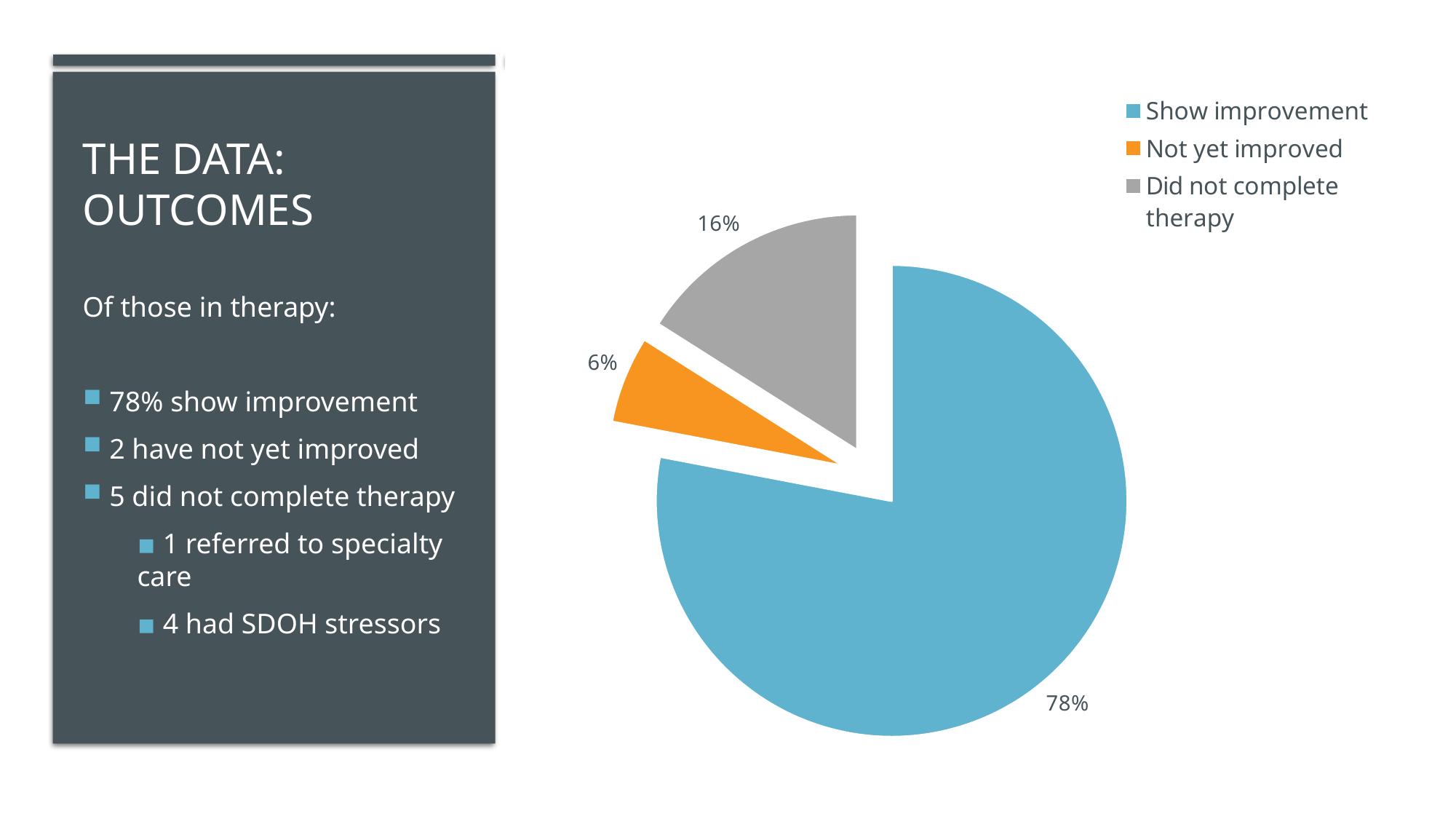
What kind of chart is shown on the slide? pie chart What share of the pie does "Show improvement" take? 78% Which slice of the pie is the largest? Show improvement Which is larger: the "Did not complete therapy" slice or the "Not yet improved" slice? Did not complete therapy How many entries does the legend list? 3 Which slice of the pie is the smallest? Not yet improved How many slices does the pie chart have? 3 What is the difference in percentage points between "Did not complete therapy" and "Not yet improved"? 10 What share of the pie does "Not yet improved" take? 6% What colour is the "Show improvement" slice? blue What colour is the "Not yet improved" slice? orange What share of the pie does "Did not complete therapy" take? 16%